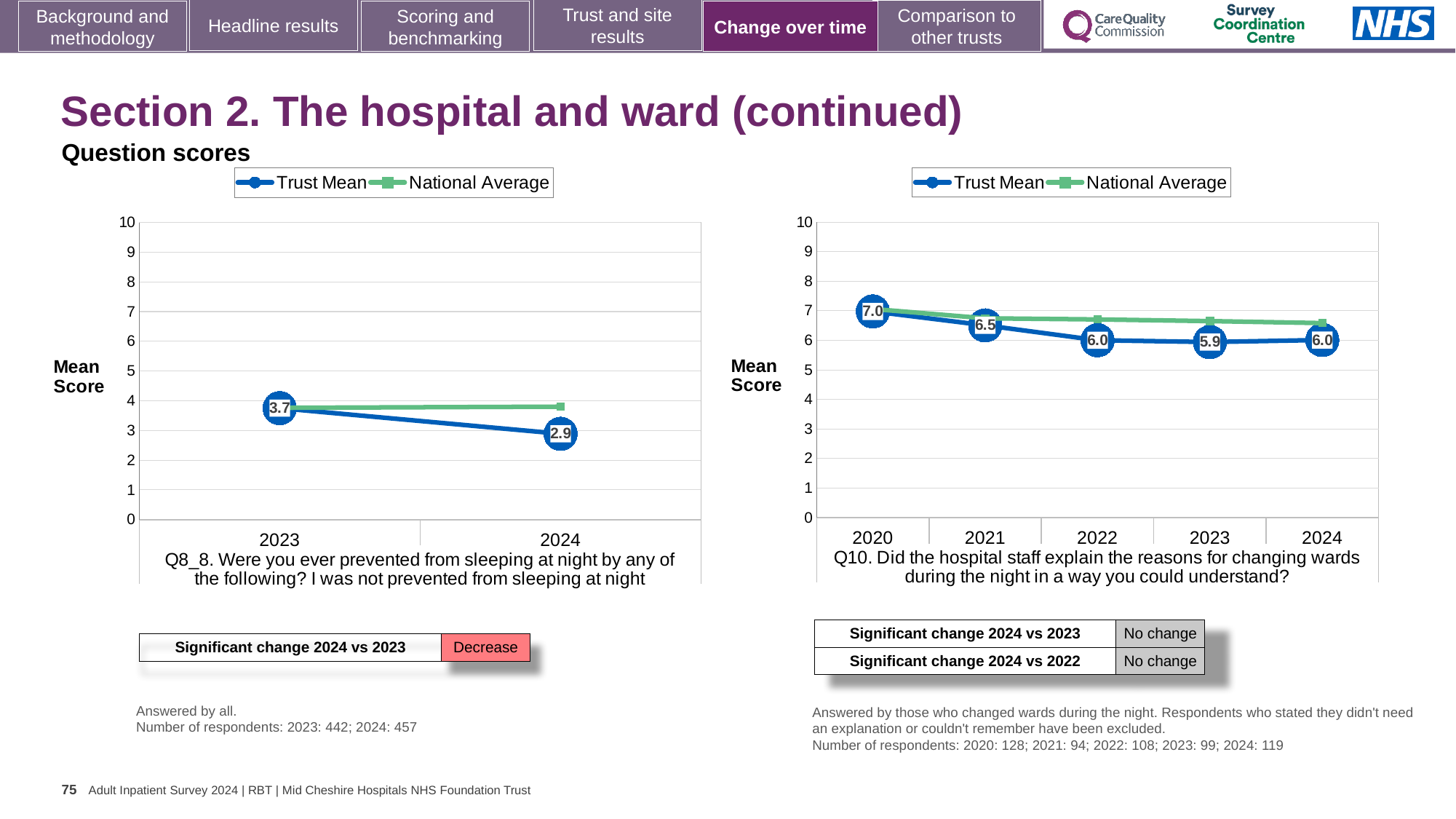
In the Q10 chart on the right, which year has the lowest Trust Mean score? 2023 In the Q8_8 chart on the left, what is the Trust Mean score for 2023? 3.7 In the Q8_8 chart on the left, by how much did the Trust Mean fall from 2023 to 2024? 0.8 In the Q10 chart on the right, which year has the highest Trust Mean score? 2020 How many years are plotted on the x axis of the Q10 chart on the right? 5 In the Q10 chart on the right, what is the Trust Mean score for 2020? 7.0 In the Q8_8 chart on the left, does the Trust Mean rise or fall from 2023 to 2024? fall In the Q10 chart on the right, what is the Trust Mean score for 2023? 5.9 How many series does the legend of the Q8_8 chart on the left list? 2 In the Q8_8 chart on the left, what is the Trust Mean score for 2024? 2.9 In the Q10 chart on the right, is the National Average for 2024 greater or less than the Trust Mean for 2024? greater In the Q10 chart on the right, what is the difference between the Trust Mean in 2020 and in 2022? 1.0